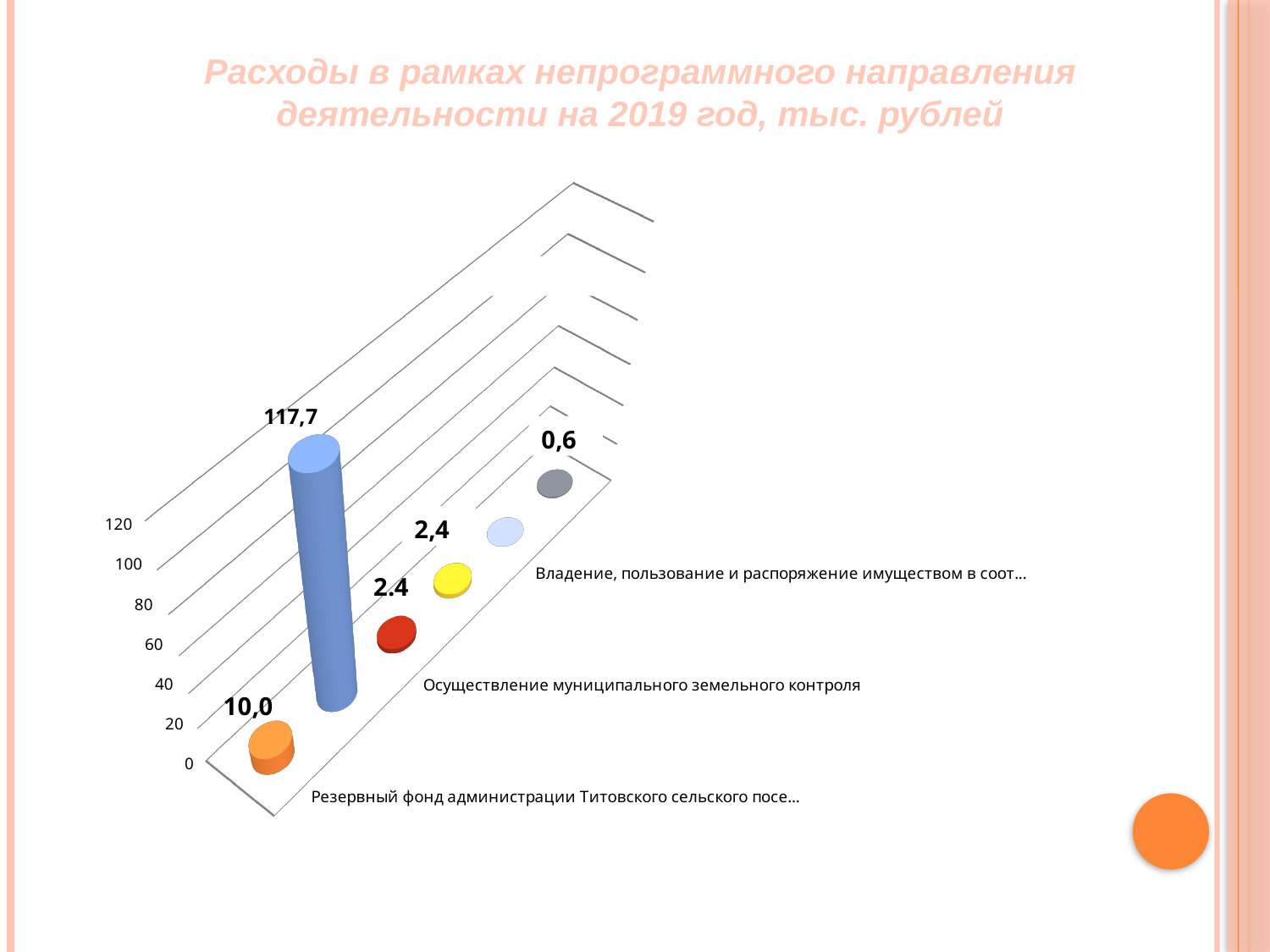
What value is labelled on the orange bar, next to the category 'Резервный фонд администрации Титовского сельского посе…'? 10,0 What is the title of the chart on the slide? Расходы в рамках непрограммного направления деятельности на 2019 год, тыс. рублей Which is larger: the value of the orange bar or the value of the grey bar? the orange bar (10,0) What is the highest value shown in the chart? 117,7 What is the difference between the blue bar (117,7) and the orange bar (10,0)? 107,7 Is the value of the tallest bar greater or less than 100? greater How many bars are plotted in the chart? 6 What kind of chart is shown on the slide? bar chart How many bars in the chart have the value 2,4? 2 What is the difference between the highest value (117,7) and the lowest value (0,6) in the chart? 117,1 What is the highest tick value shown on the value axis? 120